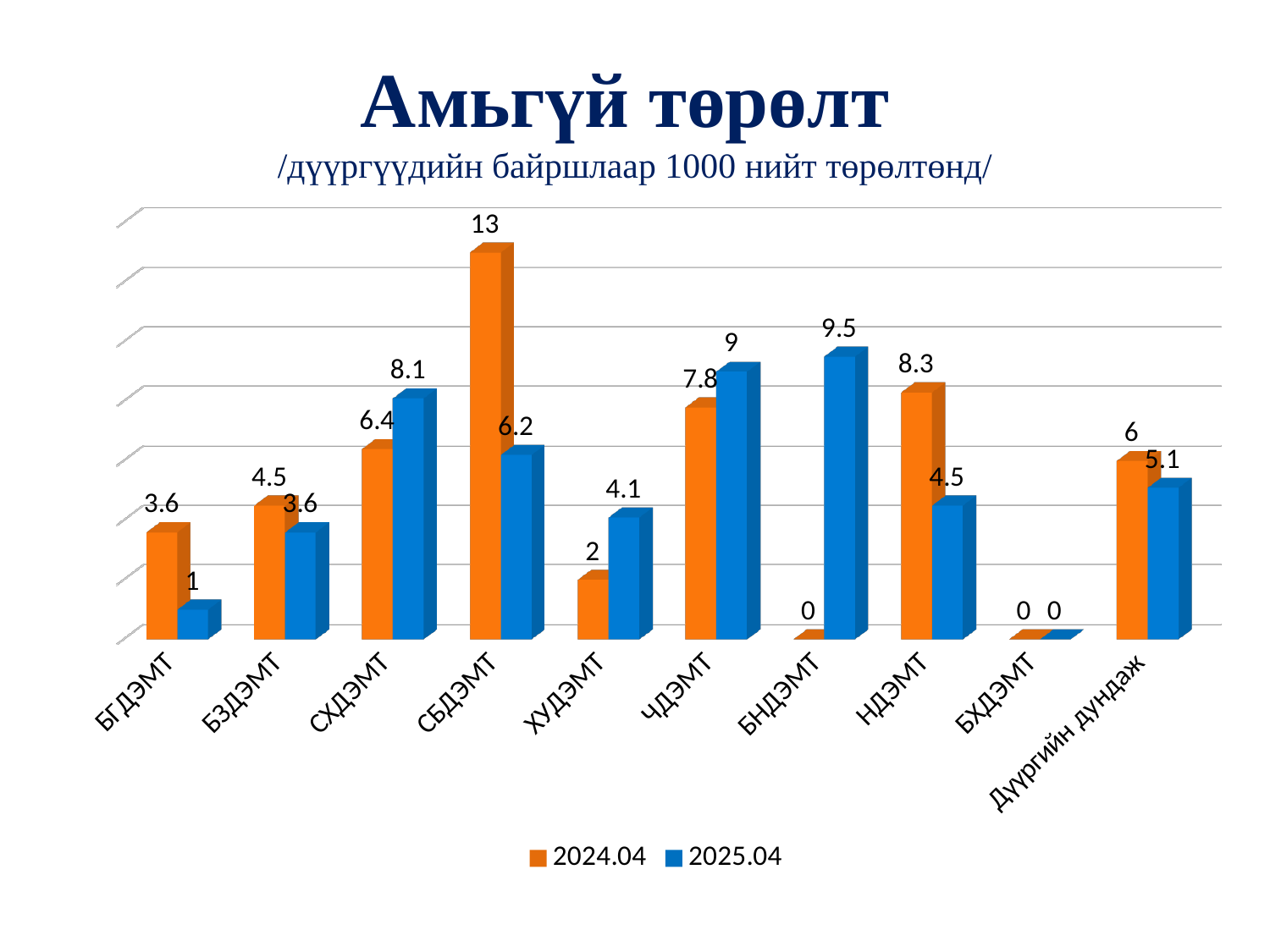
What kind of chart is shown on the slide? Bar chart What is the 2025.04 value for БГДЭМТ? 1 Which category has the highest 2024.04 value? СБДЭМТ Which category has the highest 2025.04 value? БНДЭМТ What is the difference between the 2024.04 and 2025.04 values for СБДЭМТ? 6.8 What is the 2025.04 value for БНДЭМТ? 9.5 How many series does the legend list? 2 How many categories are shown on the x axis? 10 What is the 2024.04 value for Дүүргийн дундаж? 6 Which is larger for НДЭМТ, the 2024.04 value or the 2025.04 value? 2024.04 What is the 2024.04 value for СБДЭМТ? 13 What is the difference between the 2025.04 and 2024.04 values for ХУДЭМТ? 2.1